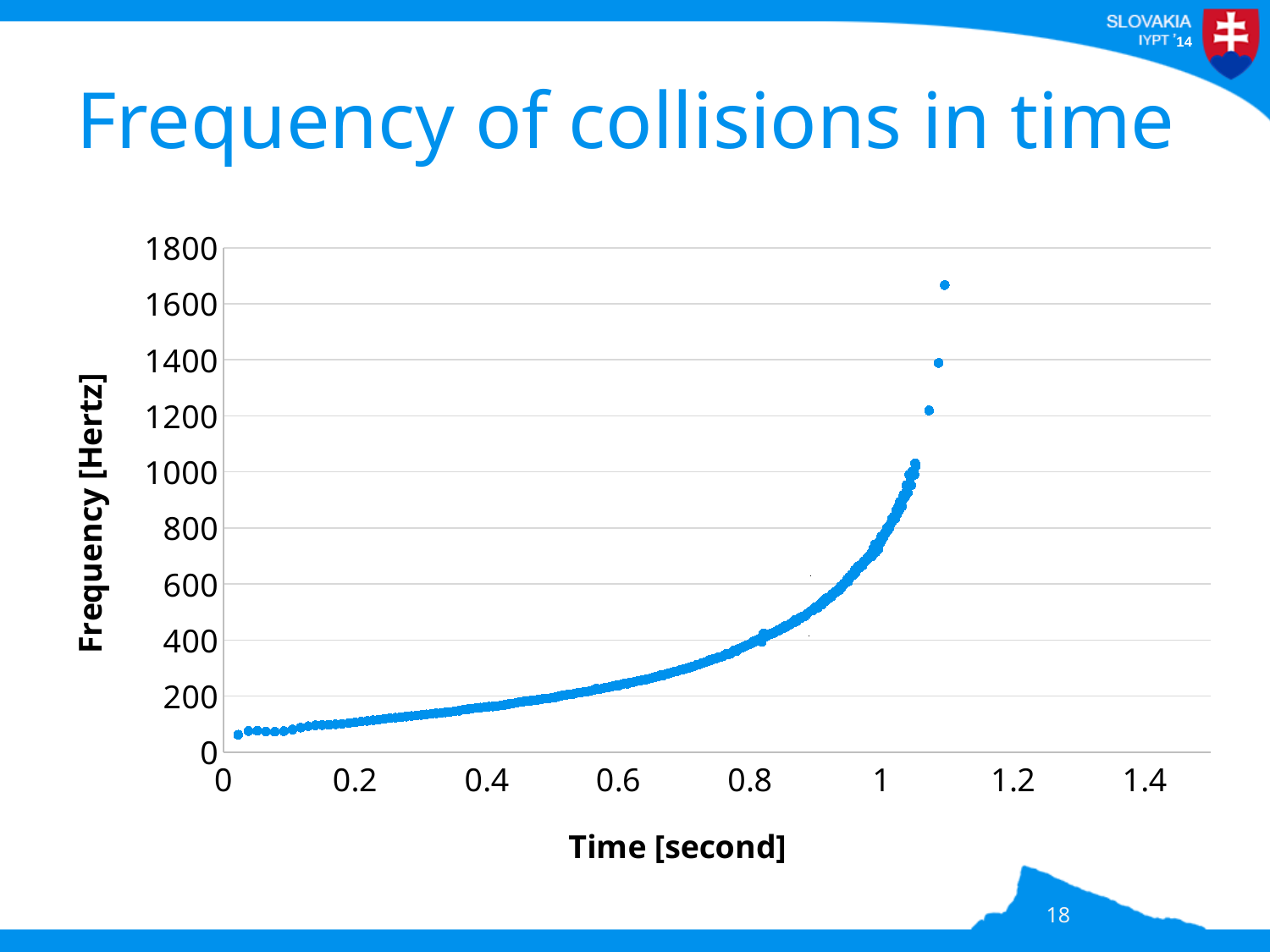
What is the title of the chart? Frequency of collisions in time Which is larger, the frequency at time 0.4 seconds or at time 0.8 seconds? 0.8 seconds Is the frequency at time 0.6 seconds greater or less than 200? greater What is the highest tick value shown on the vertical axis? 1800 What is the label of the vertical axis? Frequency [Hertz] Is the frequency at time 0.6 seconds greater or less than 400? less Is the frequency at time 0.4 seconds greater or less than 200? less Do the frequency values rise or fall as time increases along the x axis? rise What kind of chart is shown on the slide? scatter chart